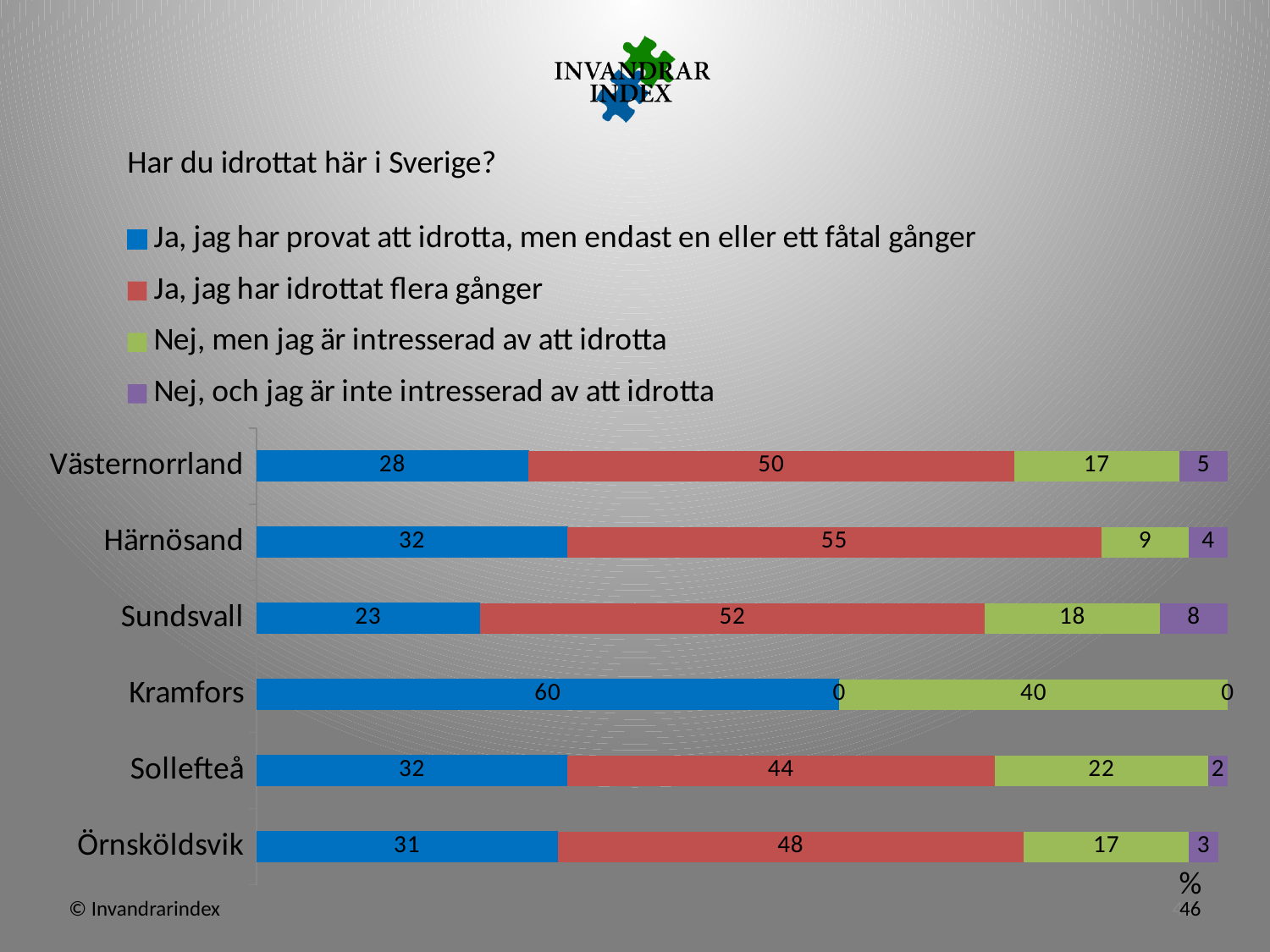
What is the total of the stacked bar for Örnsköldsvik? 99 Which category has the lowest value for 'Ja, jag har idrottat flera gånger'? Kramfors What is the value for 'Ja, jag har idrottat flera gånger' for Härnösand? 55 How many series does the legend list? 4 What is the value for 'Ja, jag har provat att idrotta, men endast en eller ett fåtal gånger' for Kramfors? 60 Which is larger: the 'Nej, och jag är inte intresserad av att idrotta' value for Sundsvall or for Västernorrland? Sundsvall What is the difference between the 'Ja, jag har idrottat flera gånger' values for Härnösand and Sollefteå? 11 Which category has the highest value for 'Nej, men jag är intresserad av att idrotta'? Kramfors How many categories (regions/municipalities) are shown on the chart? 6 What is the value for 'Nej, men jag är intresserad av att idrotta' for Sollefteå? 22 What kind of chart is shown on the slide? stacked bar chart What is the title of the chart? Har du idrottat här i Sverige?